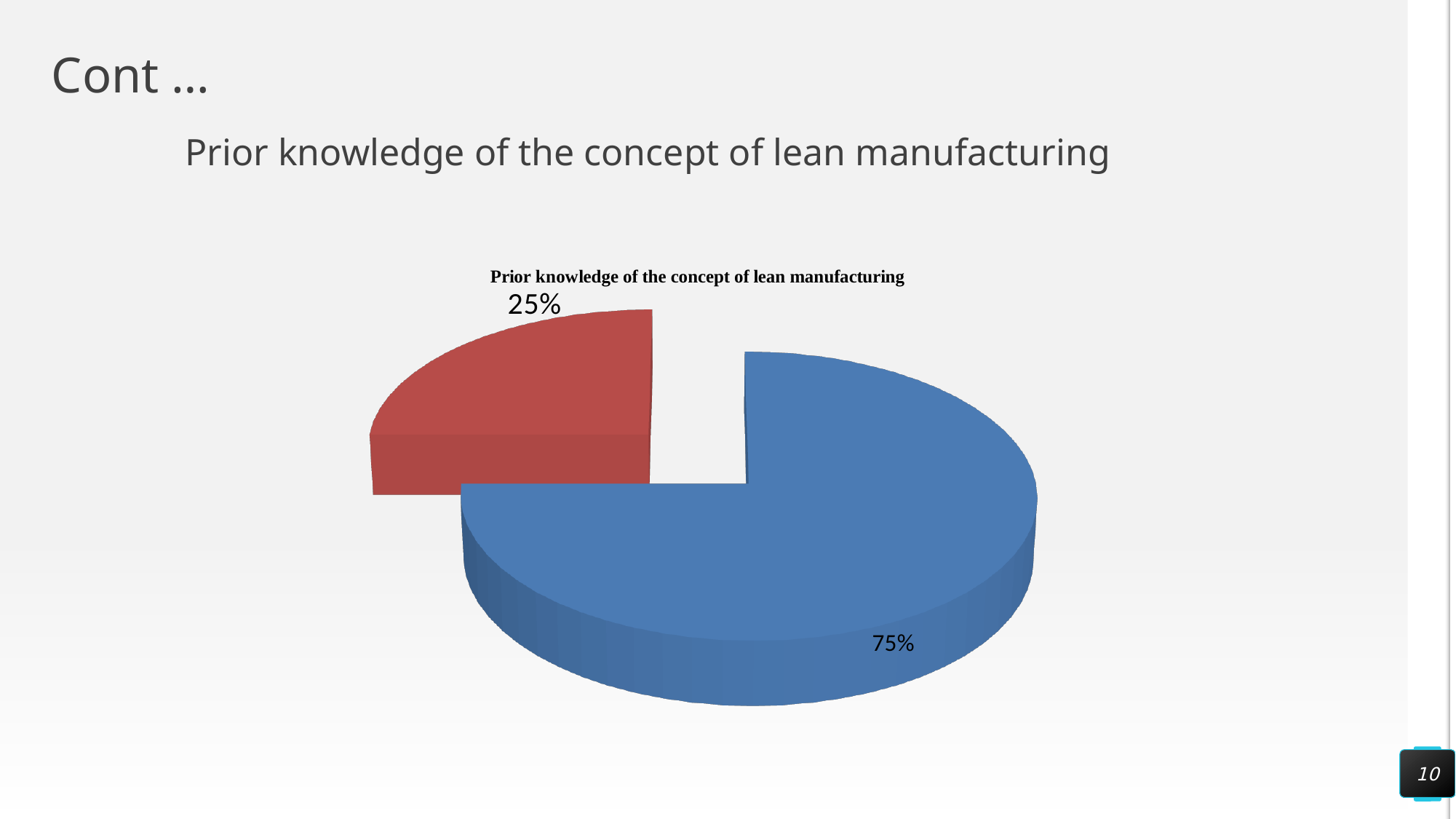
Which slice of the pie chart is the largest? The blue slice (75%) What is the title of the chart? Prior knowledge of the concept of lean manufacturing How many slices does the pie chart have? 2 What percentage is shown on the red slice of the pie chart? 25% Which slice of the pie chart is the smallest? The red slice (25%) Which slice of the pie chart is pulled out (exploded) from the rest of the pie? The red slice What percentage is shown on the blue slice of the pie chart? 75% Which slice is larger, the red slice or the blue slice? The blue slice What share of the pie does the red slice represent? 25% What kind of chart is shown on the slide? Pie chart What is the difference in percentage points between the blue slice and the red slice? 50